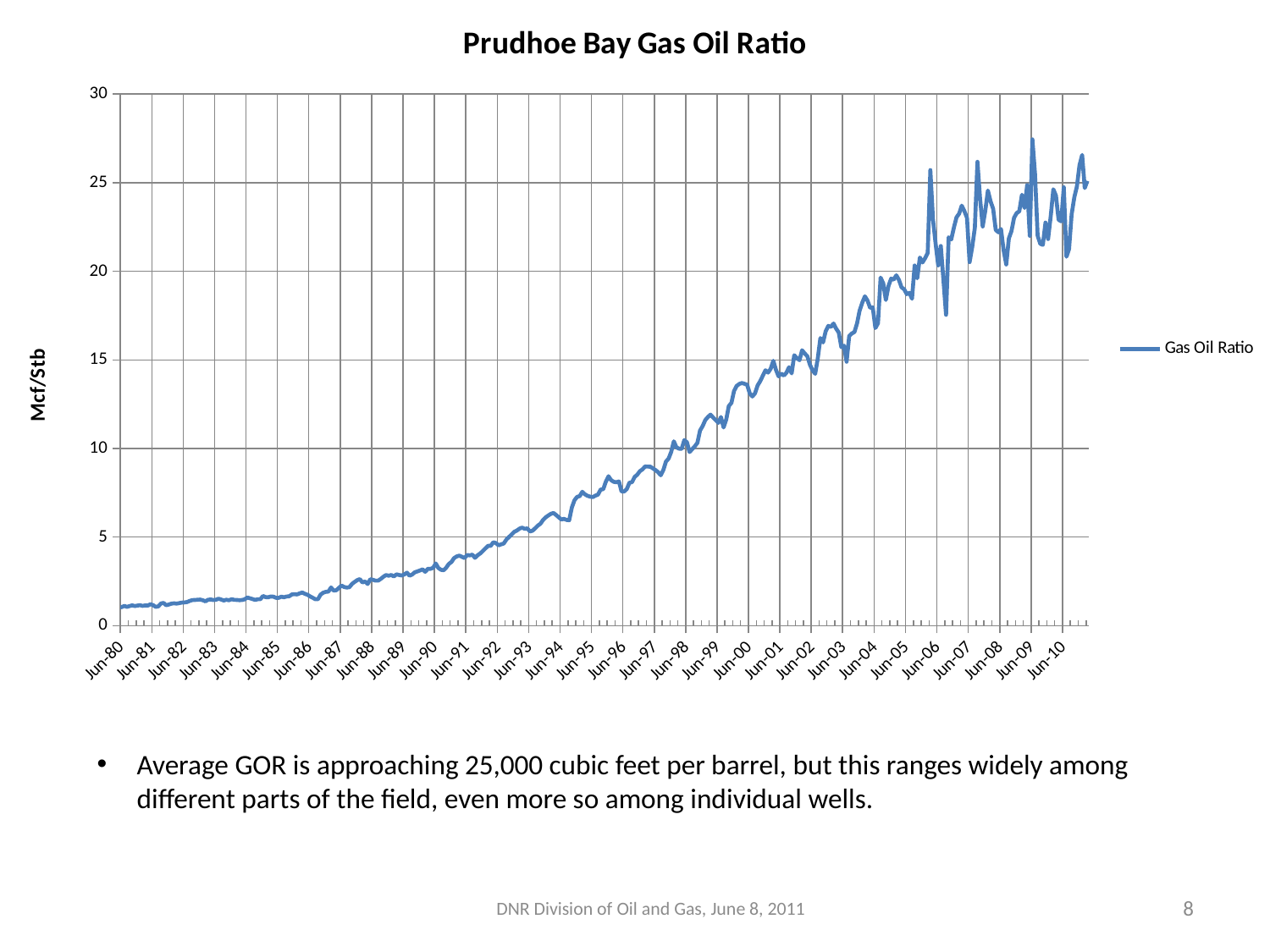
What is the label on the vertical axis of the chart? Mcf/Stb Does the Gas Oil Ratio generally rise or fall from Jun-80 to Jun-10? rise What is the title of the chart? Prudhoe Bay Gas Oil Ratio What kind of chart is shown on the slide? line chart Is the Gas Oil Ratio at Jun-95 greater or less than 10? less Which is larger, the Gas Oil Ratio at Jun-85 or at Jun-05? Jun-05 Is the Gas Oil Ratio at Jun-08 greater or less than 20? greater Is the Gas Oil Ratio at Jun-80 greater or less than 5? less How many series does the legend list? 1